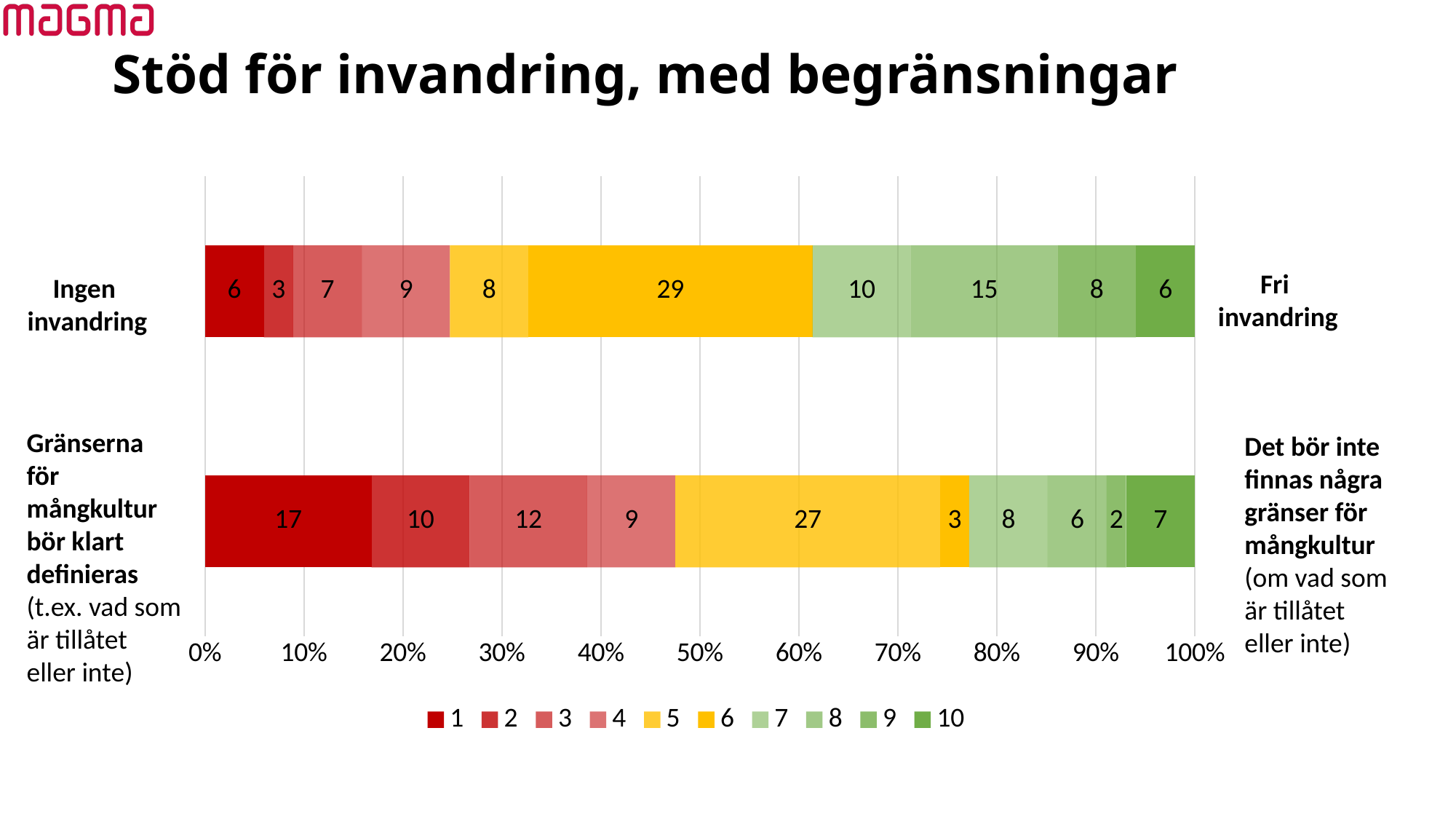
How many bars are plotted in the chart? 2 In the bottom bar (Gränserna för mångkultur bör klart definieras – Det bör inte finnas några gränser för mångkultur), what is the value for series 1? 17 What is the difference between the series 5 value in the bottom bar (27) and the series 5 value in the top bar (8)? 19 Which bar has the larger value for series 1: the top bar (Ingen invandring) or the bottom bar (Gränserna för mångkultur bör klart definieras)? The bottom bar (Gränserna för mångkultur bör klart definieras) Which series has the largest segment in the bottom bar (Gränserna för mångkultur bör klart definieras)? 5 How many series does the legend list? 10 In the top bar (Ingen invandring – Fri invandring), what is the value for series 8? 15 In the top bar (Ingen invandring – Fri invandring), what is the value for series 6? 29 Which series has the largest segment in the top bar (Ingen invandring – Fri invandring)? 6 Which series has the smallest segment in the bottom bar (Gränserna för mångkultur bör klart definieras)? 9 In the bottom bar (Gränserna för mångkultur bör klart definieras), what is the value for series 5? 27 What kind of chart is shown on the slide? Stacked bar chart